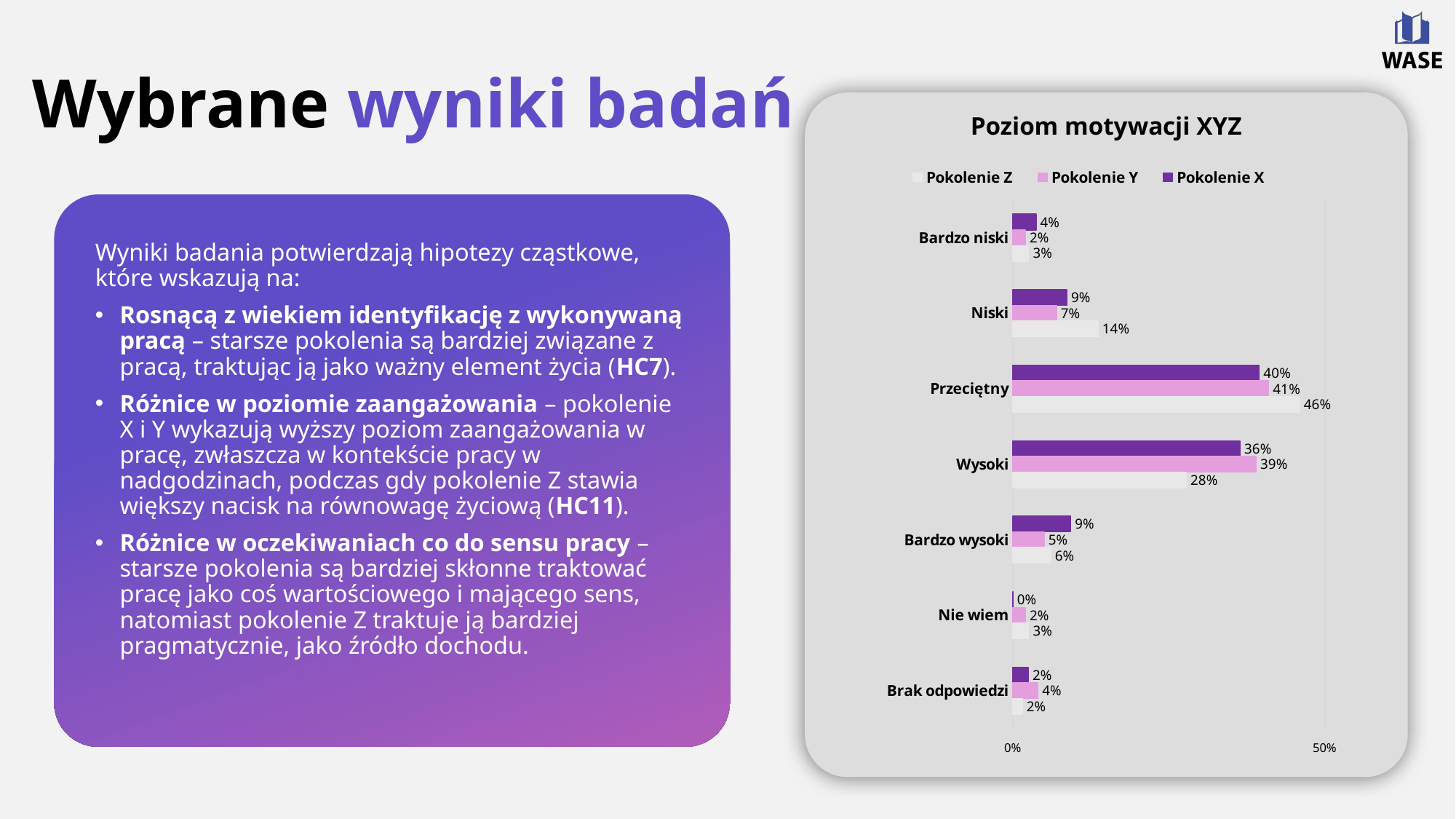
Which category has the lowest value for Pokolenie X? Nie wiem What is the value for Pokolenie Z in the Przeciętny category? 46% What type of chart is shown on the slide? Bar chart What is the difference between Pokolenie Y and Pokolenie Z in the Wysoki category? 11% What is the value for Pokolenie Y in the Niski category? 7% How many categories are shown on the chart's vertical axis? 7 What is the title of the chart? Poziom motywacji XYZ How many series does the chart legend list? 3 In the Niski category, which is larger: the value for Pokolenie Z or for Pokolenie X? Pokolenie Z What is the value for Pokolenie X in the Bardzo wysoki category? 9% Which category has the highest value for Pokolenie Y? Przeciętny What is the value for Pokolenie X in the Wysoki category? 36%